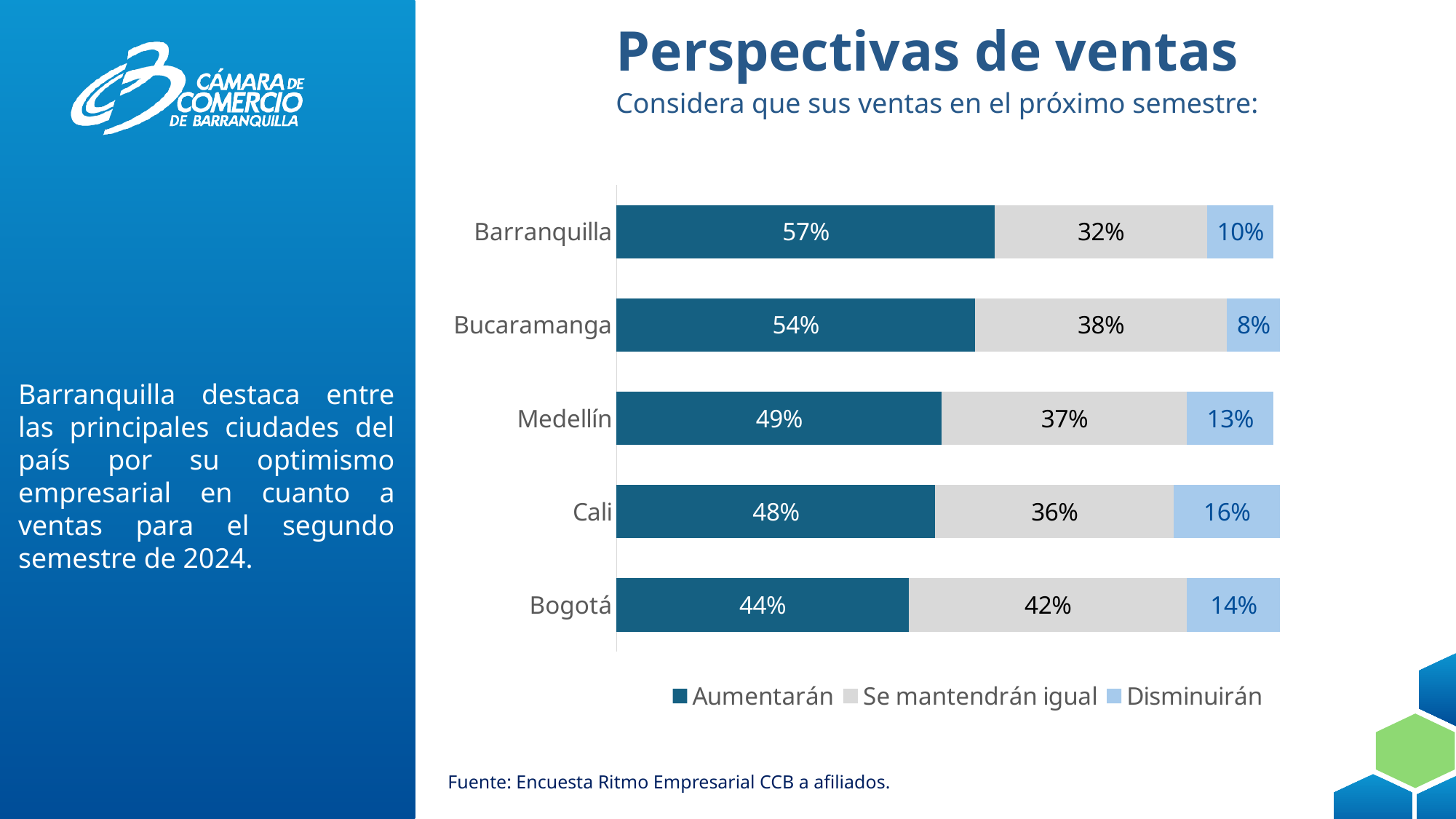
What is the difference between the 'Aumentarán' values for Barranquilla and Bogotá? 13% How many series does the legend list? 3 How many cities are shown in the chart? 5 What kind of chart is shown on the slide? Stacked bar chart What percentage of Barranquilla respondents say sales will increase (Aumentarán)? 57% What is the 'Disminuirán' value for Cali? 16% What is the total of the stacked bar for Medellín? 99% Which city has the lowest 'Disminuirán' percentage? Bucaramanga Which is larger: the 'Se mantendrán igual' value for Bucaramanga or for Medellín? Bucaramanga What is the title of the chart? Perspectivas de ventas Which city has the highest 'Aumentarán' percentage? Barranquilla What is the 'Se mantendrán igual' value for Bogotá? 42%